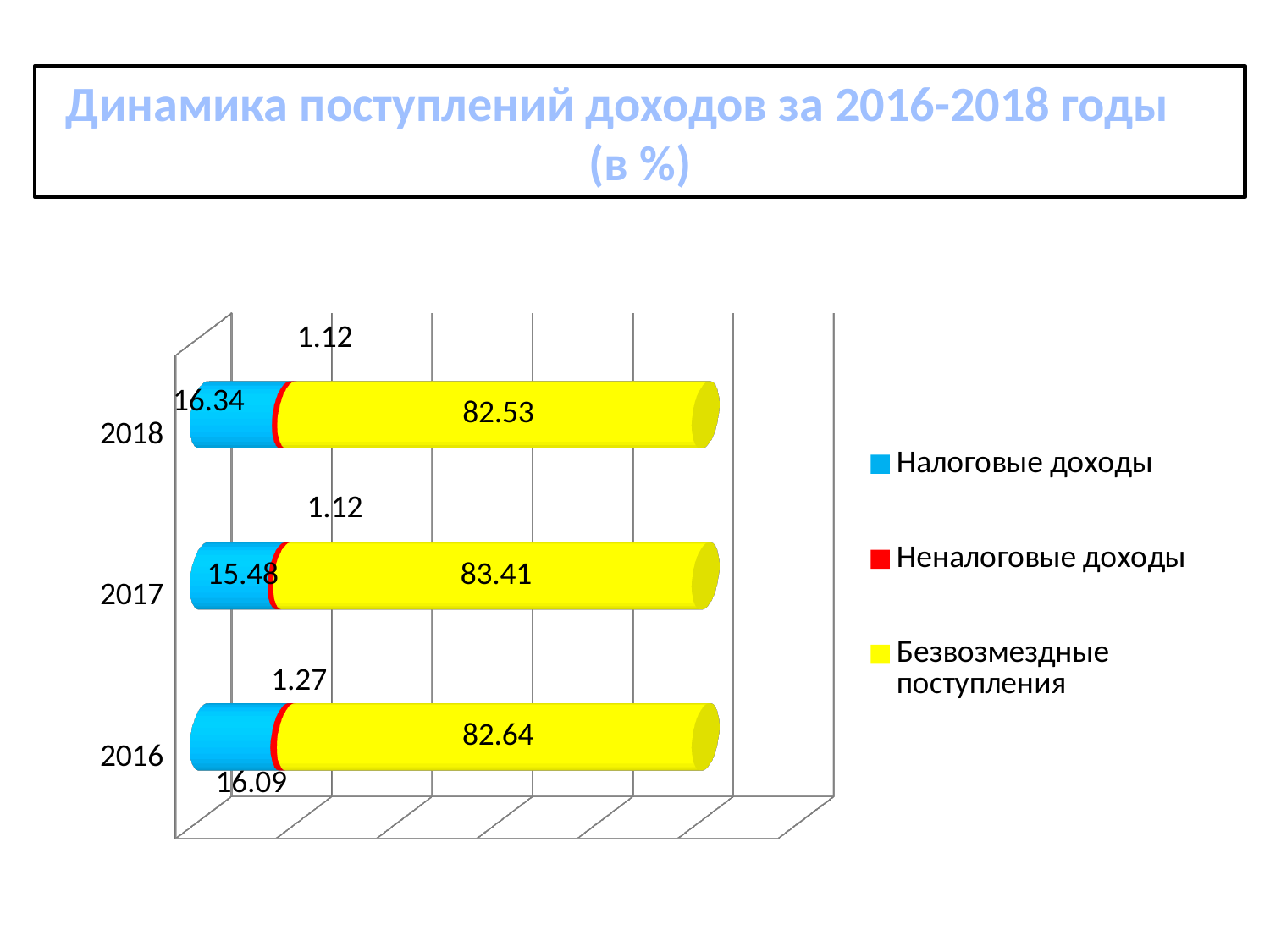
What is the difference between the Налоговые доходы values for 2018 and 2017? 0.86 Which colour represents Неналоговые доходы in the chart? Red What is the value for Безвозмездные поступления in 2017? 83.41 In which year is the value for Налоговые доходы lowest? 2017 What is the value for Налоговые доходы in 2018? 16.34 How many series does the legend list? 3 What kind of chart is shown on the slide? Stacked bar chart Which is larger: Безвозмездные поступления in 2016 or in 2018? 2016 What is the value for Неналоговые доходы in 2016? 1.27 In which year is the value for Безвозмездные поступления highest? 2017 What is the total of the stacked bar for 2016? 100.00 How many years are shown on the chart? 3